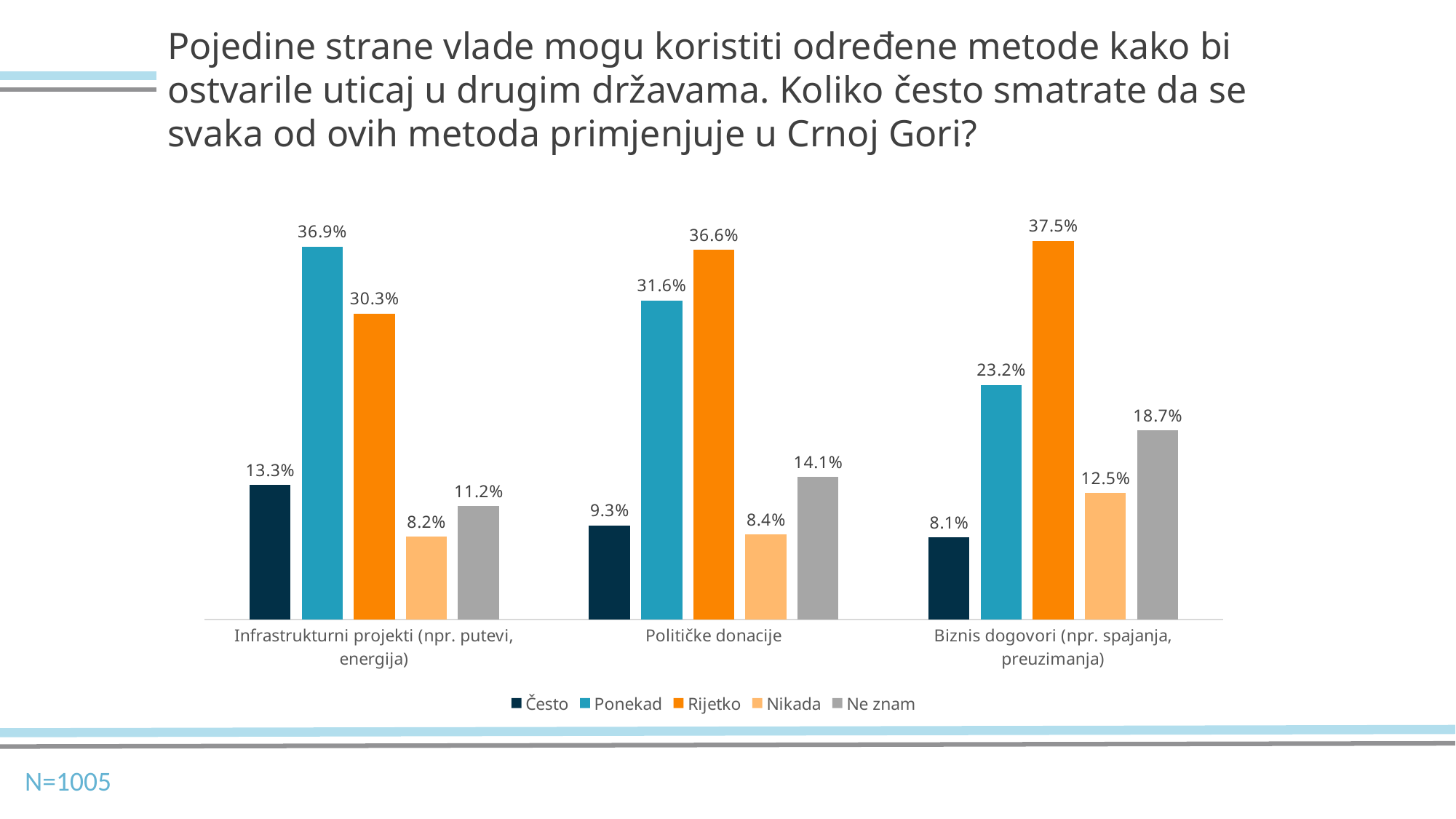
What is the value for Rijetko in the Političke donacije category? 36.6% What kind of chart is shown on the slide? Bar chart How many series does the legend list? 5 What is the value for Ne znam in the Biznis dogovori (npr. spajanja, preuzimanja) category? 18.7% What is the value for Često in the Političke donacije category? 9.3% What is the value for Ponekad in the Infrastrukturni projekti (npr. putevi, energija) category? 36.9% How many categories are shown on the x axis? 3 Which category has the highest value for Rijetko? Biznis dogovori (npr. spajanja, preuzimanja) Which series is shown in orange in the legend? Rijetko What is the difference between the Ponekad and Rijetko values in the Infrastrukturni projekti (npr. putevi, energija) category? 6.6% Which is larger in the Biznis dogovori (npr. spajanja, preuzimanja) category: Ponekad or Ne znam? Ponekad Which category has the lowest value for Često? Biznis dogovori (npr. spajanja, preuzimanja)